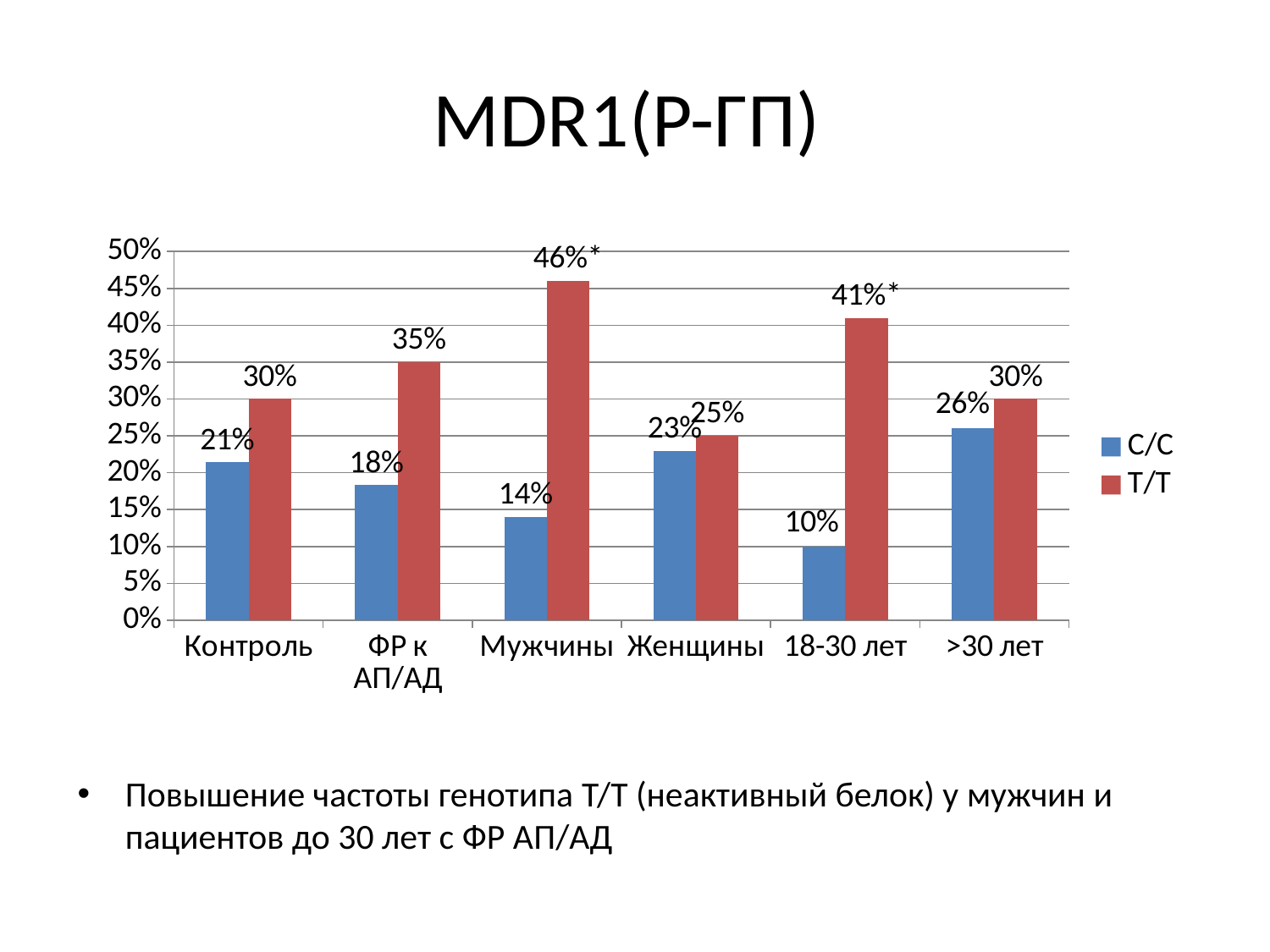
What is the difference between the T/T and C/C values for 18-30 лет? 31% Is the T/T value for Мужчины greater or less than 40%? greater How many categories are shown on the x axis? 6 Which category has the lowest C/C value? 18-30 лет What is the value of the T/T series for Мужчины? 46%* How many series does the legend list? 2 What is the value of the T/T series for ФР к АП/АД? 35% What is the value of the C/C series for 18-30 лет? 10% Which is larger for Женщины, the C/C value or the T/T value? T/T Which category has the highest T/T value? Мужчины What is the value of the C/C series for Контроль? 21% What kind of chart is shown on the slide? bar chart